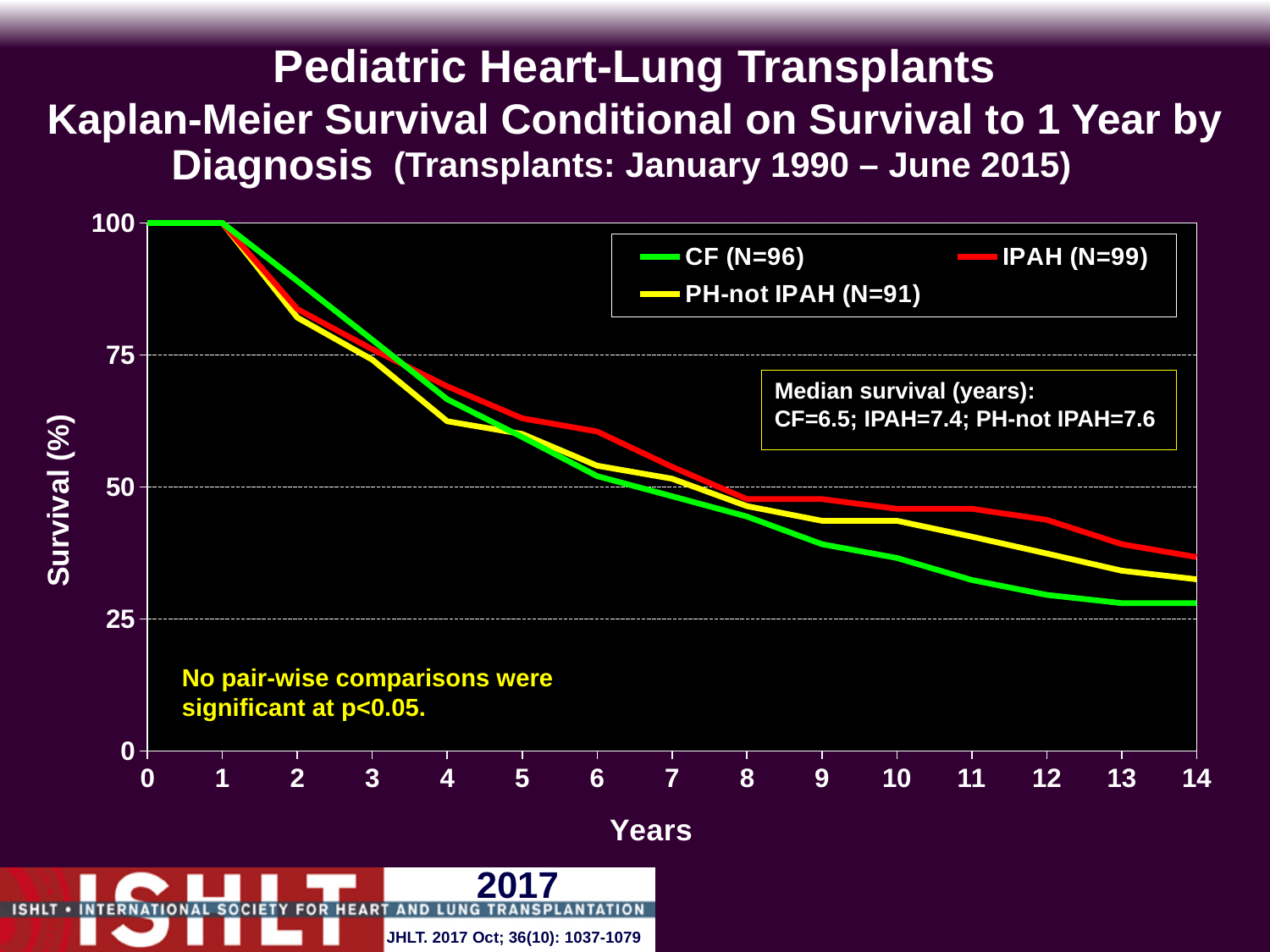
What kind of chart is shown on the slide? Line chart What is the median survival in years for the CF group, as stated on the slide? 6.5 Is the survival value for IPAH at 2 years greater or less than 75? greater Do the survival curves rise or fall as years increase? fall At 14 years, which series has the higher survival: IPAH or CF? IPAH Is the survival value for CF at 14 years greater or less than 50? less What is the median survival in years for the PH-not IPAH group, as stated on the slide? 7.6 What is the difference in median survival (years) between the PH-not IPAH group and the CF group? 1.1 Which diagnosis group has the highest median survival? PH-not IPAH What is the median survival in years for the IPAH group, as stated on the slide? 7.4 Which diagnosis group has the lowest median survival? CF How many series does the legend list? 3